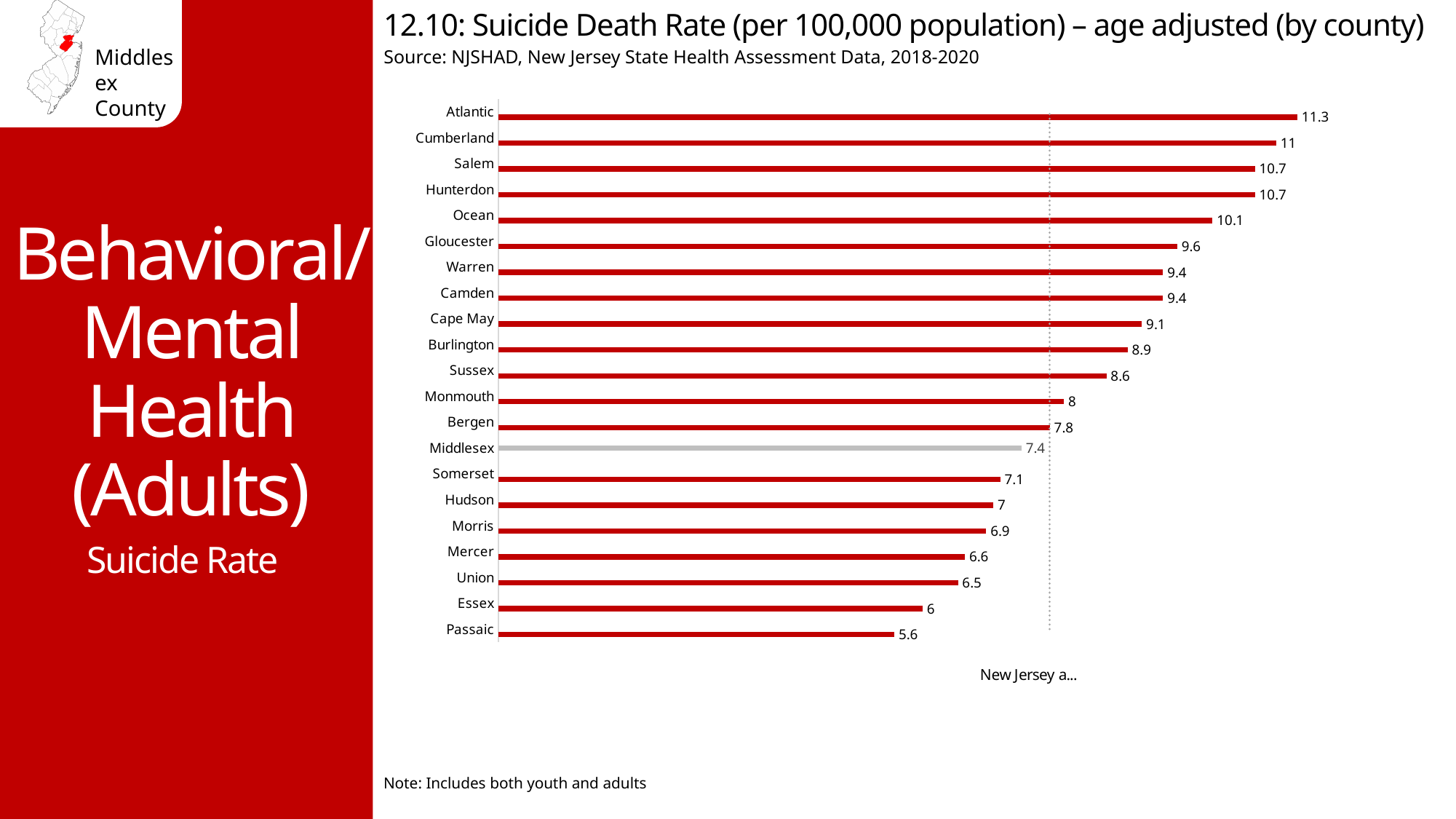
Which county has the lowest suicide death rate? Passaic What kind of chart is shown on the slide? Bar chart What is the suicide death rate for Middlesex County? 7.4 Which county has a higher suicide death rate, Hudson or Morris? Hudson How many counties are shown in the chart? 21 What is the suicide death rate for Passaic County? 5.6 What is the suicide death rate for Atlantic County? 11.3 Which county has a higher suicide death rate, Ocean or Gloucester? Ocean What is the difference between the suicide death rates of Atlantic and Passaic counties? 5.7 What is the difference between the suicide death rates of Middlesex and Bergen counties? 0.4 Which county has the highest suicide death rate? Atlantic Which county's bar is shown in grey instead of red? Middlesex